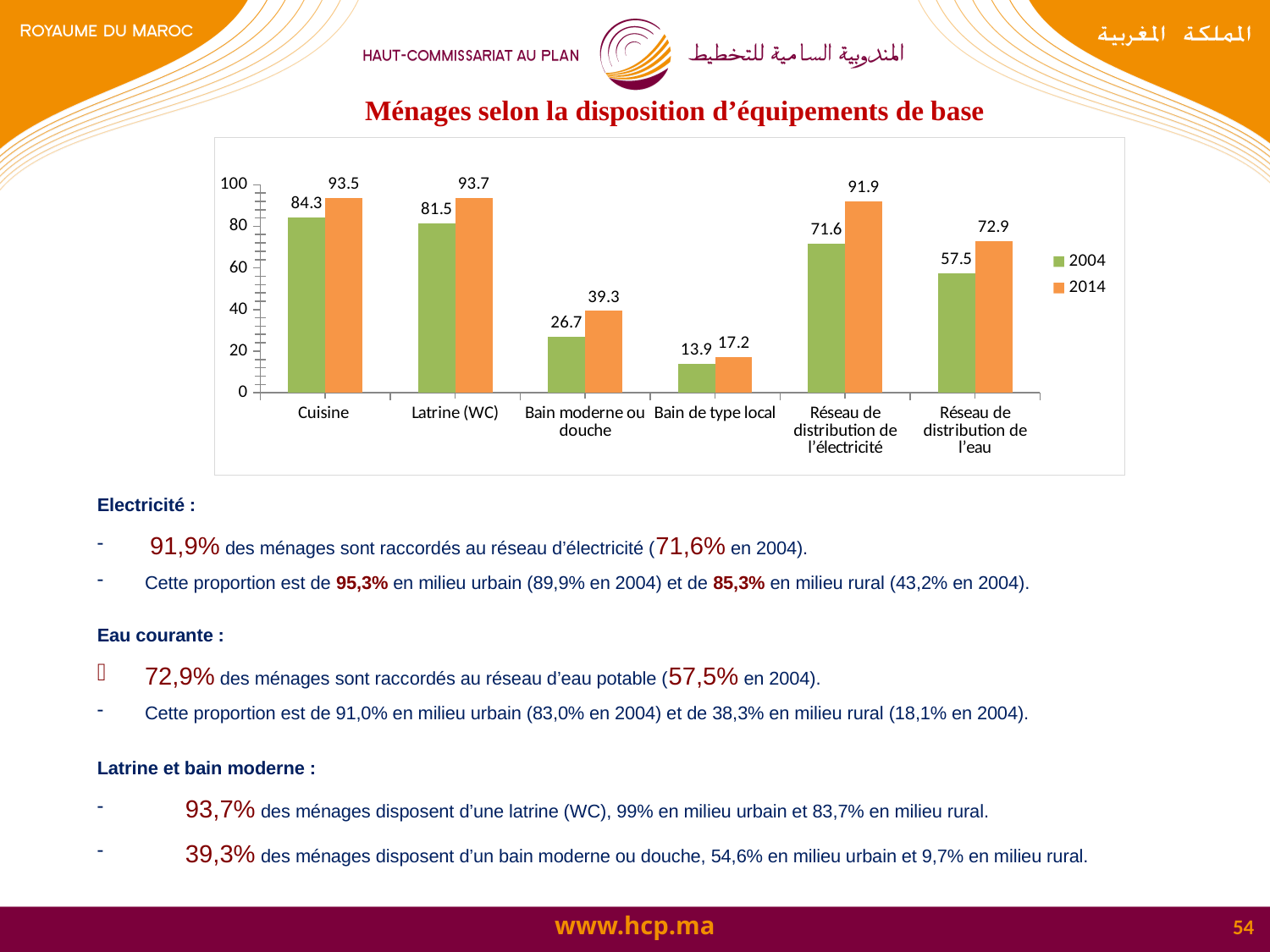
What is the 2004 value for Réseau de distribution de l'eau? 57.5 Which category has the highest 2014 value? Latrine (WC) What kind of chart is shown on the slide? Bar chart What is the 2004 value for Bain de type local? 13.9 How many categories are shown on the x axis? 6 Which is larger: the 2004 value for Cuisine or the 2004 value for Latrine (WC)? Cuisine Which category has the lowest 2004 value? Bain de type local What is the difference between the 2014 and 2004 values for Bain moderne ou douche? 12.6 What is the difference between the 2014 and 2004 values for Réseau de distribution de l'électricité? 20.3 How many series does the legend list? 2 What is the 2014 value for Cuisine? 93.5 Which series is shown in orange in the legend? 2014